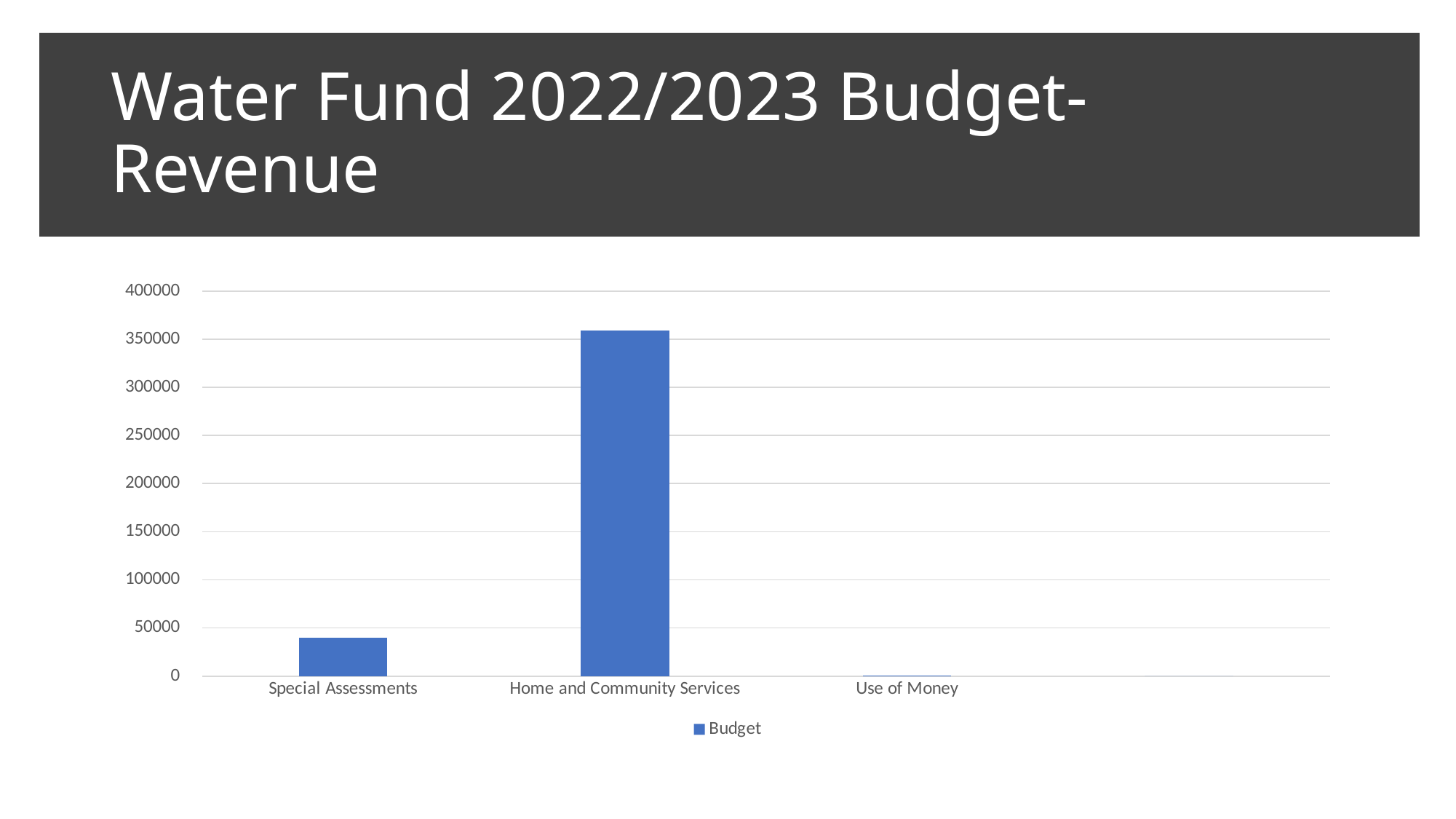
What is the title of the slide containing the chart? Water Fund 2022/2023 Budget-Revenue Is the Budget value for Home and Community Services greater or less than 300000? greater Is the Budget value for Use of Money greater or less than 50000? less What kind of chart is shown on the slide? bar chart How many series does the chart legend list? 1 Which category has the lowest Budget value? Use of Money Is the Budget value for Home and Community Services greater or less than 400000? less What is the name of the series shown in the chart legend? Budget How many categories are shown on the x axis of the chart? 3 Which category has the highest Budget value? Home and Community Services Which is larger, the Budget value for Special Assessments or for Home and Community Services? Home and Community Services